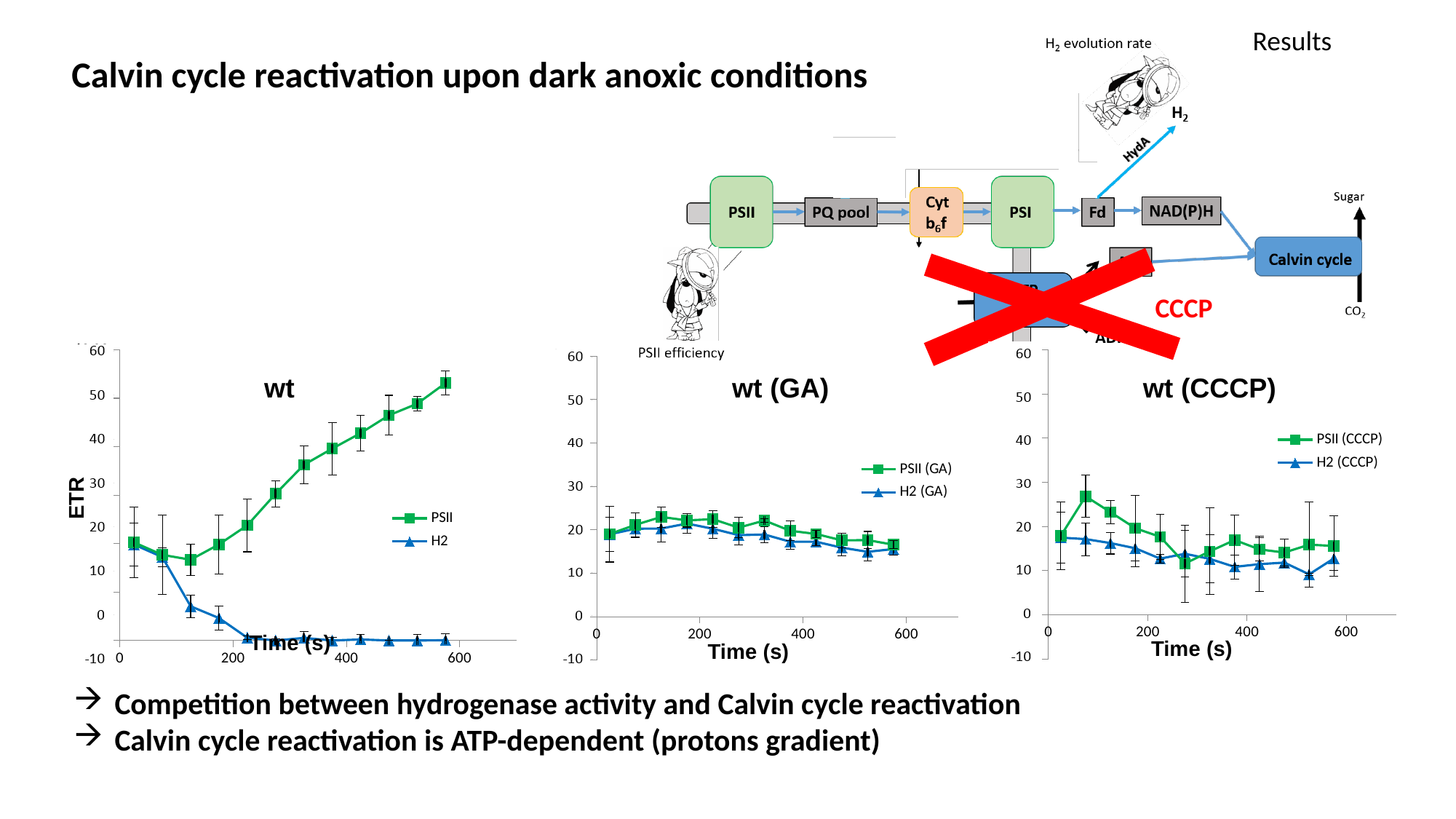
In the chart titled "wt", is the PSII value at the last time point (near 580 s) greater or less than 50? greater In the chart titled "wt", what kind of chart is shown? line chart In the chart titled "wt (GA)", what are the two legend entries? PSII (GA) and H2 (GA) In the chart titled "wt", does the H2 series rise or fall as time increases from 0 s to 200 s? fall In the chart titled "wt", how many series does the legend list? 2 In the chart titled "wt", what is the label on the y axis? ETR In the chart titled "wt (GA)", is the highest PSII (GA) value greater or less than 30? less In the chart titled "wt", does the PSII series rise or fall as time increases from 200 s to 600 s? rise In the chart titled "wt (CCCP)", is the PSII (CCCP) value at the last time point (near 580 s) greater or less than 30? less In the chart titled "wt", at the last time point, which series has the larger value, PSII or H2? PSII In the chart titled "wt (CCCP)", how many series does the legend list? 2